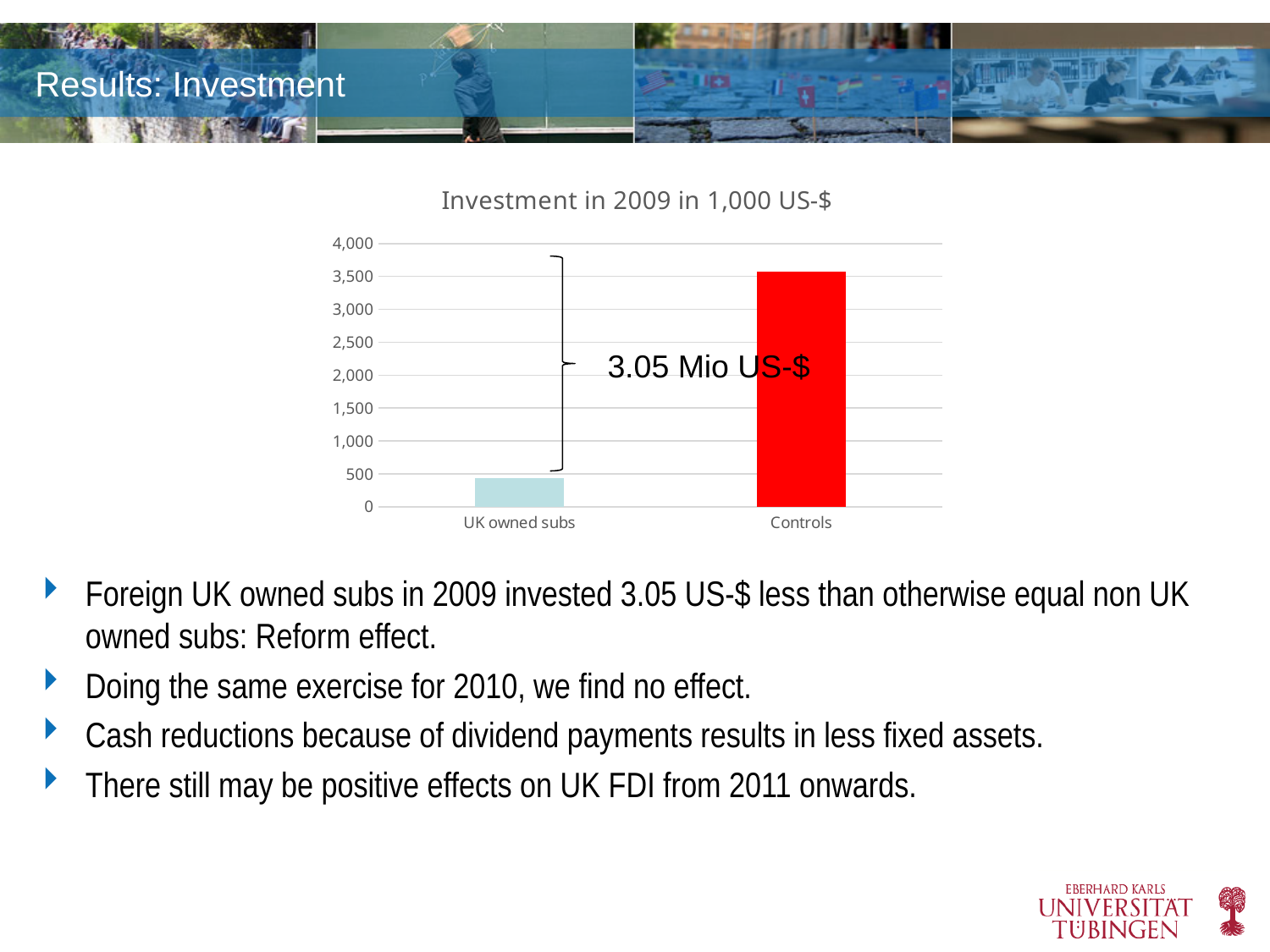
What difference between the two bars is annotated on the chart? 3.05 Mio US-$ Which category has the lowest investment in the chart? UK owned subs Is the value for UK owned subs greater or less than 1,000? less Is the value for Controls greater or less than 4,000? less Which category has the highest investment in the chart? Controls What kind of chart is shown on the slide? bar chart Is the value for Controls greater or less than 3,000? greater How many categories are shown on the x axis of the chart? 2 What is the highest value shown on the y axis of the chart? 4,000 Which is larger, the investment for UK owned subs or for Controls? Controls What is the title of the chart? Investment in 2009 in 1,000 US-$